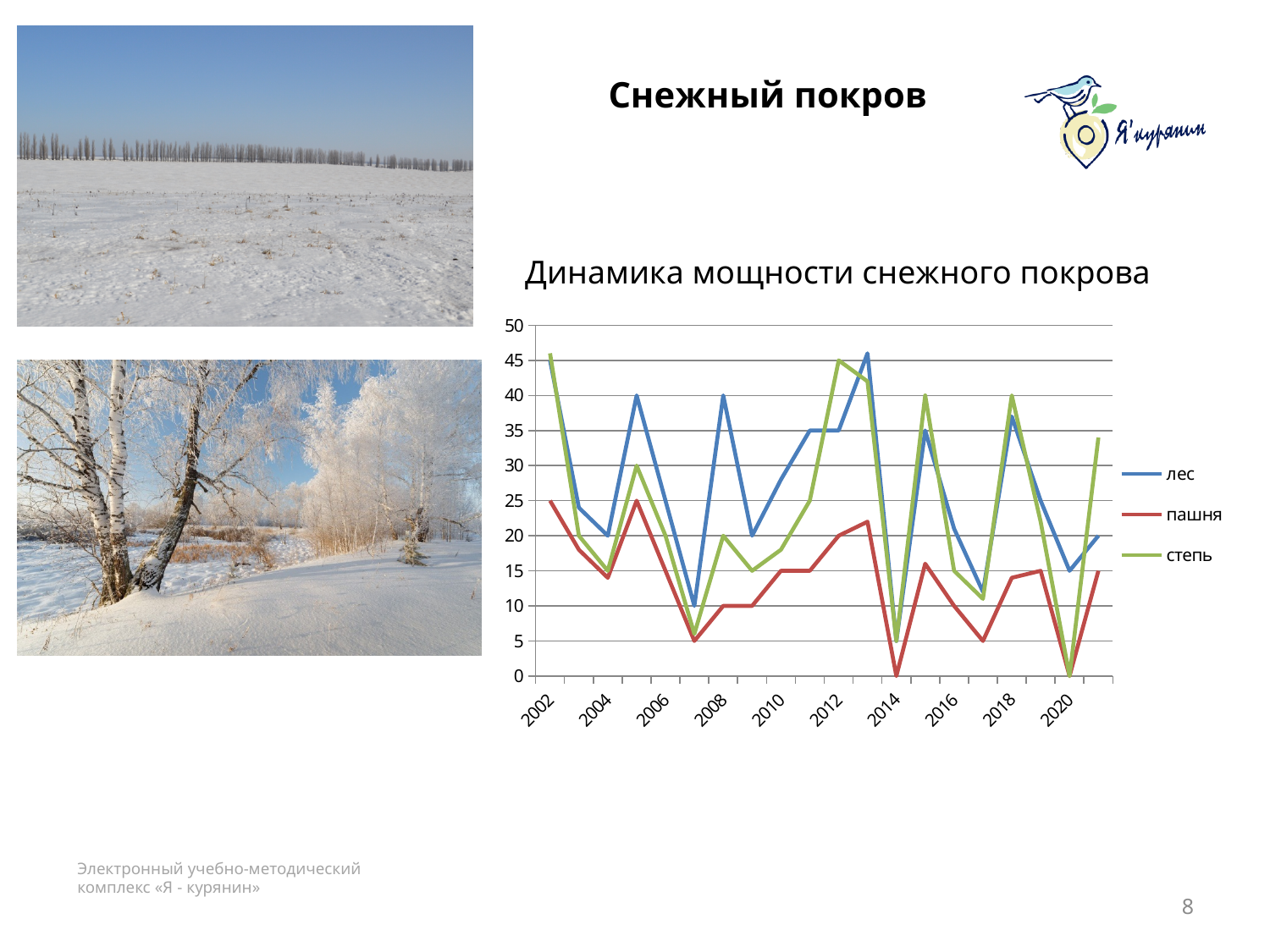
What is the value for степь in 2020? 0 How many series does the chart legend list? 3 What is the value for пашня in 2014? 0 Is the value for степь in 2012 greater or less than 40? greater What is the title of the chart? Динамика мощности снежного покрова Which series has the lowest value in 2014? пашня Is the value for пашня in 2007 greater or less than 10? less In 2013, which is larger: the value for лес or the value for пашня? лес Is the value for лес in 2013 greater or less than 40? greater Which series are listed in the chart legend? лес, пашня, степь What kind of chart is shown on the slide? line chart Does the value for пашня rise or fall from 2002 to 2007? fall